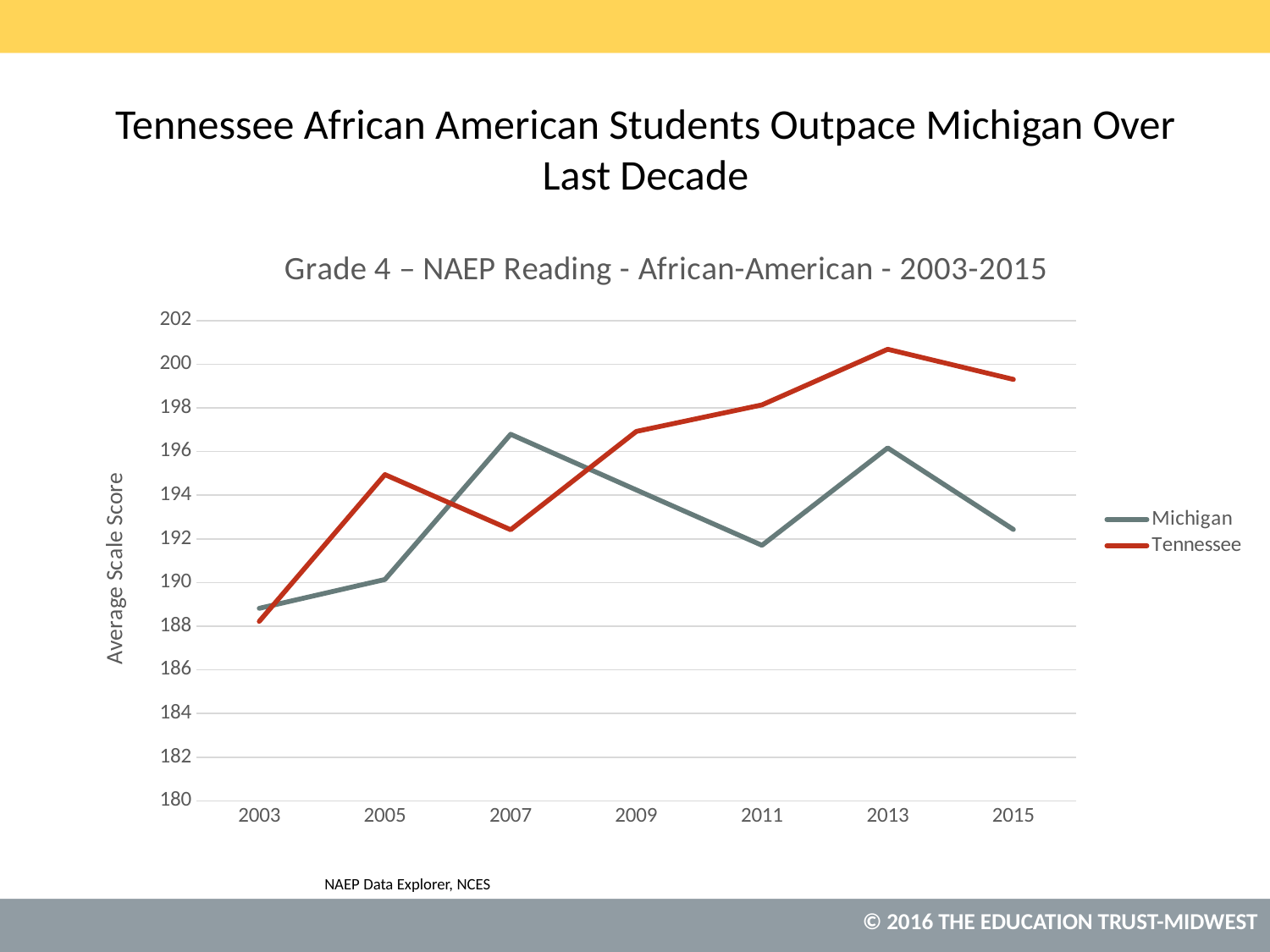
What is the title of the vertical axis? Average Scale Score In which year is Tennessee's average scale score lowest? 2003 Is the value for Tennessee in 2013 greater or less than 200? greater In which year is Michigan's average scale score lowest? 2003 In 2015, which state has the higher average scale score, Michigan or Tennessee? Tennessee Is the value for Michigan in 2015 greater or less than 194? less In 2007, which state has the higher average scale score, Michigan or Tennessee? Michigan How many years are plotted along the x axis? 7 What kind of chart is shown on the slide? line chart How many series does the legend list? 2 Does Tennessee's average scale score generally rise or fall from 2003 to 2015? rise In which year does Tennessee reach its highest average scale score? 2013